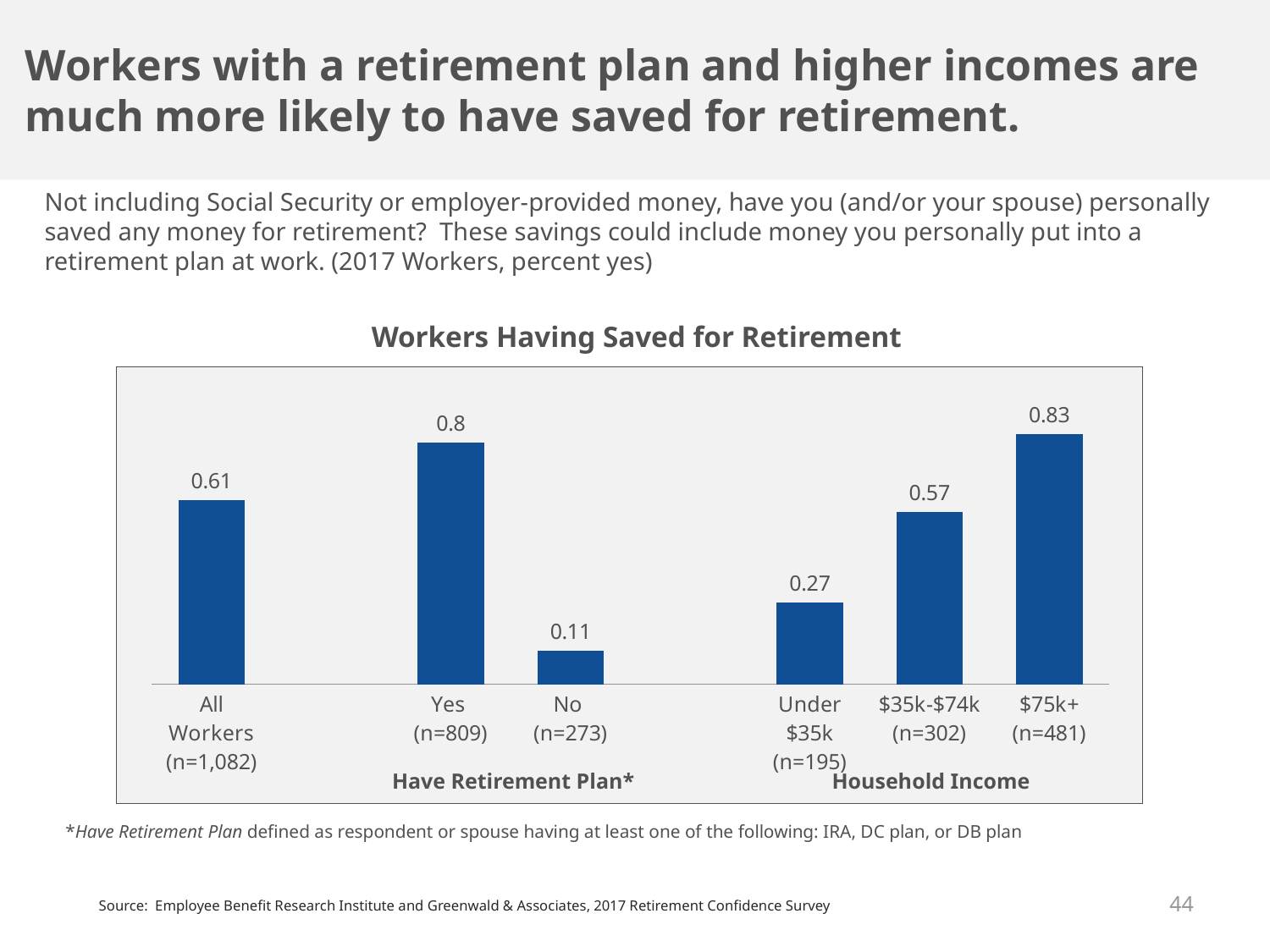
What is the value for workers who answered Yes (n=809) to having a retirement plan? 0.8 What is the value for workers who answered No (n=273) to having a retirement plan? 0.11 Which category has the lowest value in the chart? No (n=273) What is the value for workers with household income Under $35k (n=195)? 0.27 What is the difference between the values for $75k+ (n=481) and Under $35k (n=195)? 0.56 What is the difference between the values for Yes (n=809) and No (n=273) under Have Retirement Plan? 0.69 Which is larger, the value for All Workers or the value for $35k-$74k? All Workers Which category has the highest value in the chart? $75k+ (n=481) What is the value for workers with household income $35k-$74k (n=302)? 0.57 What type of chart is shown on the slide? Bar chart What is the value for All Workers (n=1,082) in the Workers Having Saved for Retirement chart? 0.61 How many bars are plotted in the chart? 6